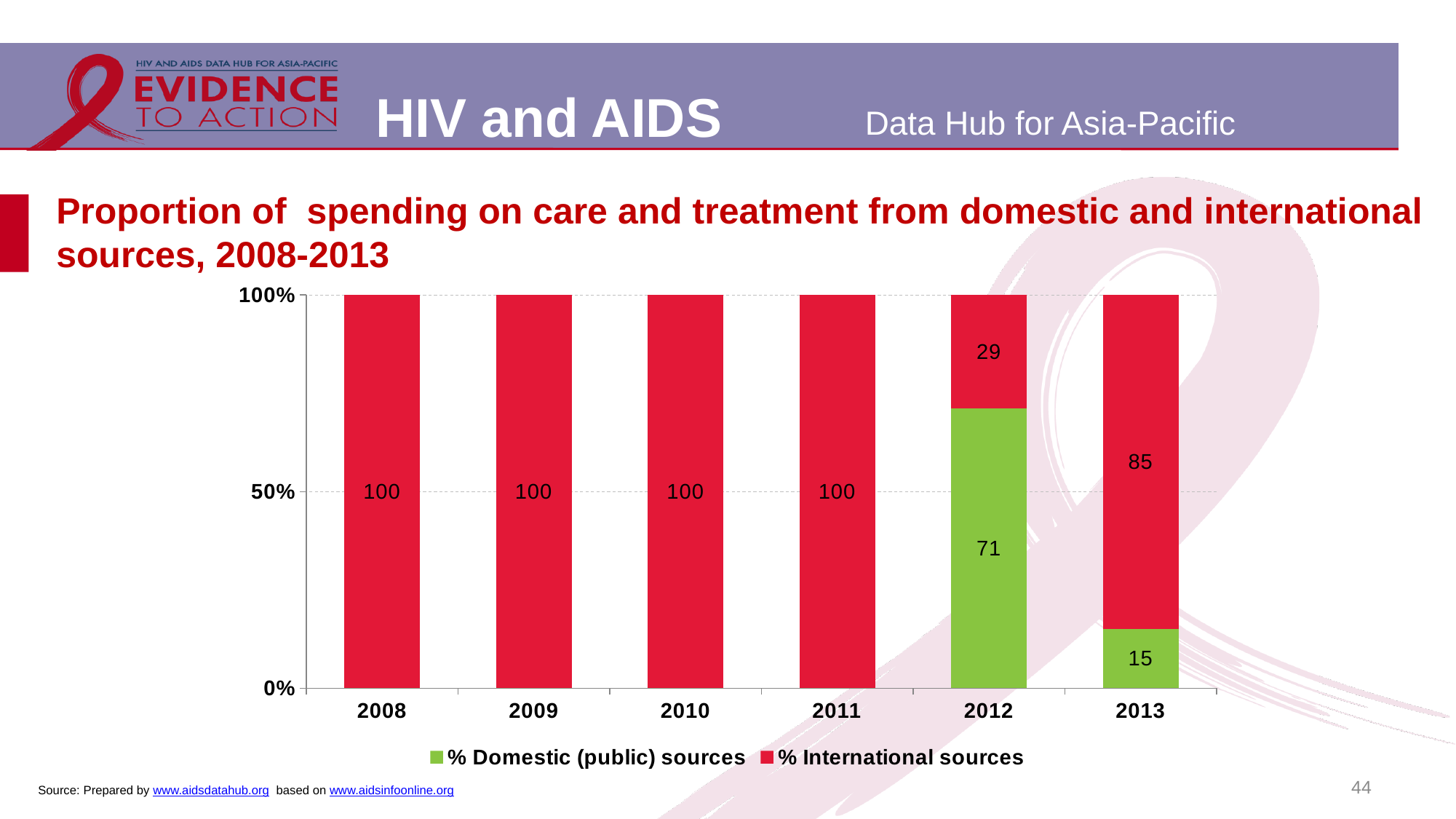
How many years are shown on the x axis? 6 What is the difference between % International sources in 2013 and in 2012? 56 In 2013, which is larger: % Domestic (public) sources or % International sources? % International sources What is the value for % International sources in 2012? 29 What is the value for % Domestic (public) sources in 2013? 15 What is the value for % International sources in 2008? 100 How many series does the legend list? 2 What is the value for % Domestic (public) sources in 2012? 71 What kind of chart is shown on the slide? Stacked bar chart Which year has the highest value for % Domestic (public) sources? 2012 Which year has the lowest value for % International sources? 2012 What colour represents % Domestic (public) sources in the chart? Green